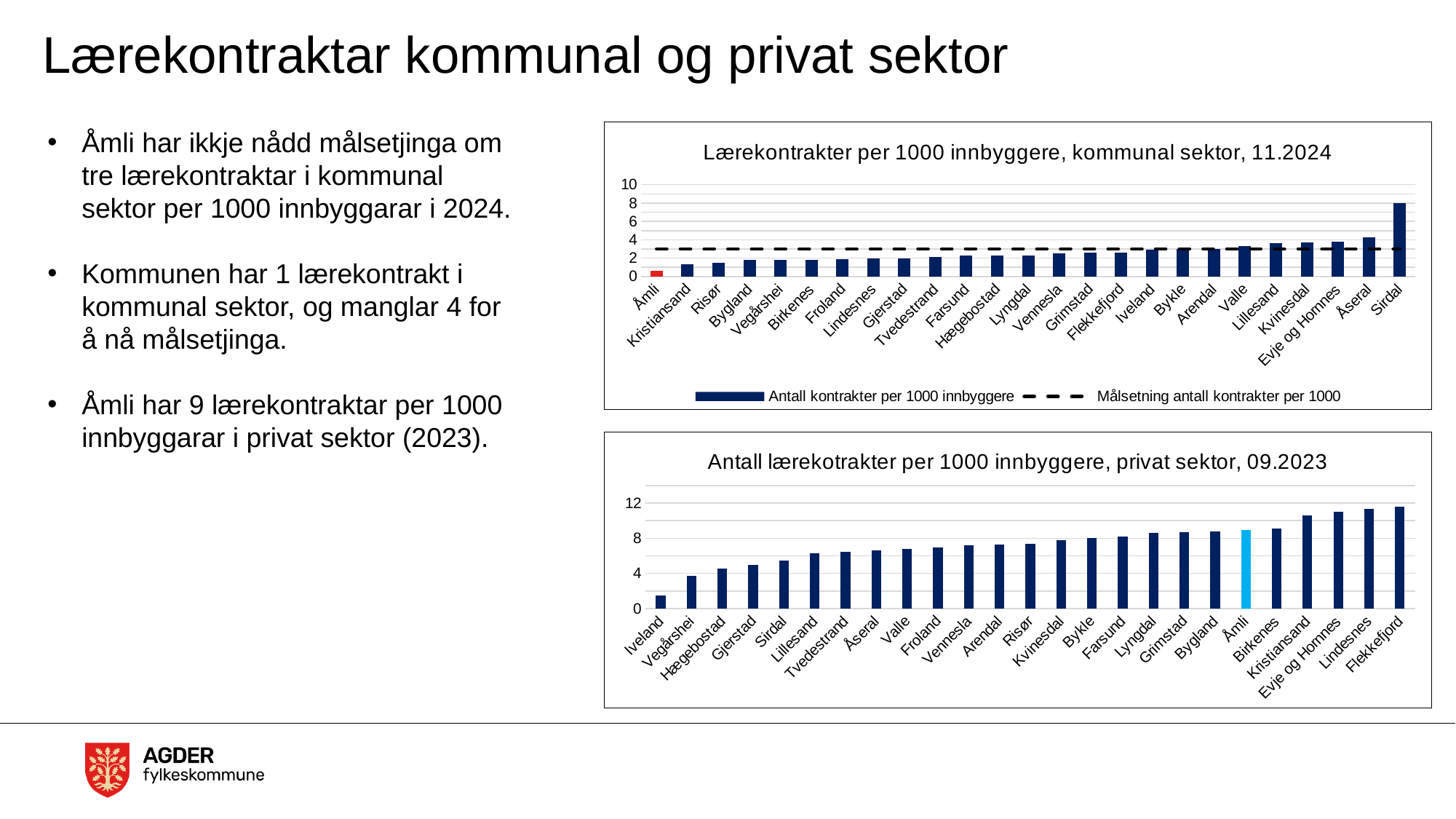
What kind of chart is the bottom chart (privat sektor, 09.2023)? bar chart In the bottom chart (privat sektor, 09.2023), which municipality has the lowest value? Iveland In the top chart (kommunal sektor, 11.2024), how many municipalities are shown on the x axis? 25 In the bottom chart (privat sektor, 09.2023), do the values rise or fall from left to right along the x axis? rise In the top chart (kommunal sektor, 11.2024), which municipality has the lowest value? Åmli In the top chart (kommunal sektor, 11.2024), is the value for Åmli greater or less than 2? less In the bottom chart (privat sektor, 09.2023), which municipality has the highest value? Flekkefjord In the top chart (kommunal sektor, 11.2024), which municipality has the highest number of contracts per 1000 inhabitants? Sirdal In the bottom chart (privat sektor, 09.2023), is the value for Iveland greater or less than 4? less In the top chart (kommunal sektor, 11.2024), which is larger, the value for Sirdal or the value for Kristiansand? Sirdal In the top chart (kommunal sektor, 11.2024), how many entries does the legend list? 2 In the top chart (kommunal sektor, 11.2024), is the value for Sirdal greater or less than 6? greater